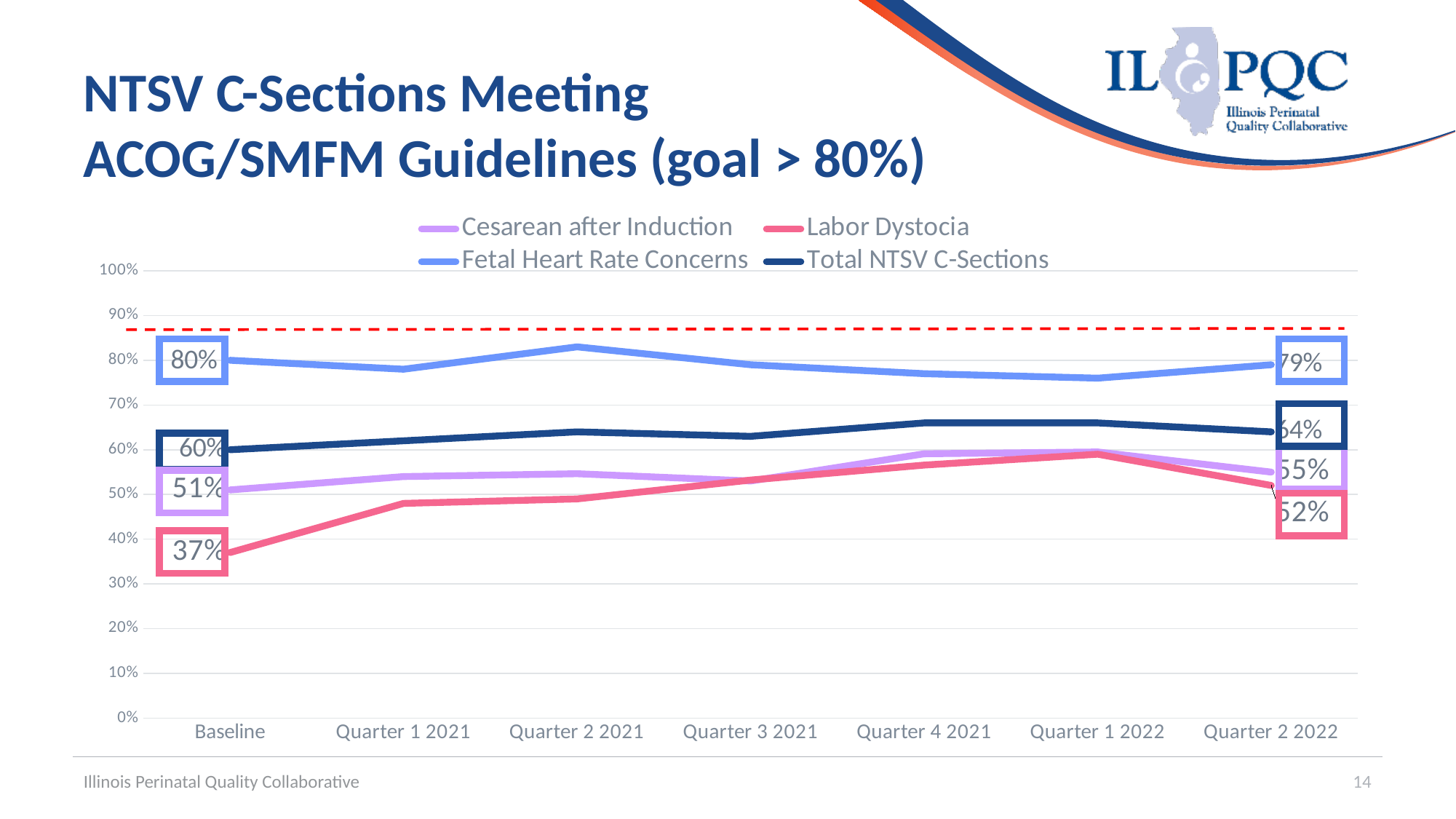
What is the value for Labor Dystocia at Baseline? 37% How many time points are shown on the x axis? 7 Which series has the lowest value at Baseline? Labor Dystocia Is the value for Fetal Heart Rate Concerns at Quarter 1 2022 greater or less than 80%? less What is the value for Cesarean after Induction at Quarter 2 2022? 55% What is the difference between the Labor Dystocia values at Quarter 2 2022 and Baseline? 15% How many series does the legend list? 4 Does the Labor Dystocia line rise or fall from Baseline to Quarter 1 2022? rise What is the value for Total NTSV C-Sections at Quarter 2 2022? 64% What type of chart is shown on the slide? line chart What is the value for Fetal Heart Rate Concerns at Baseline? 80% Which series has the highest value at Quarter 2 2022? Fetal Heart Rate Concerns